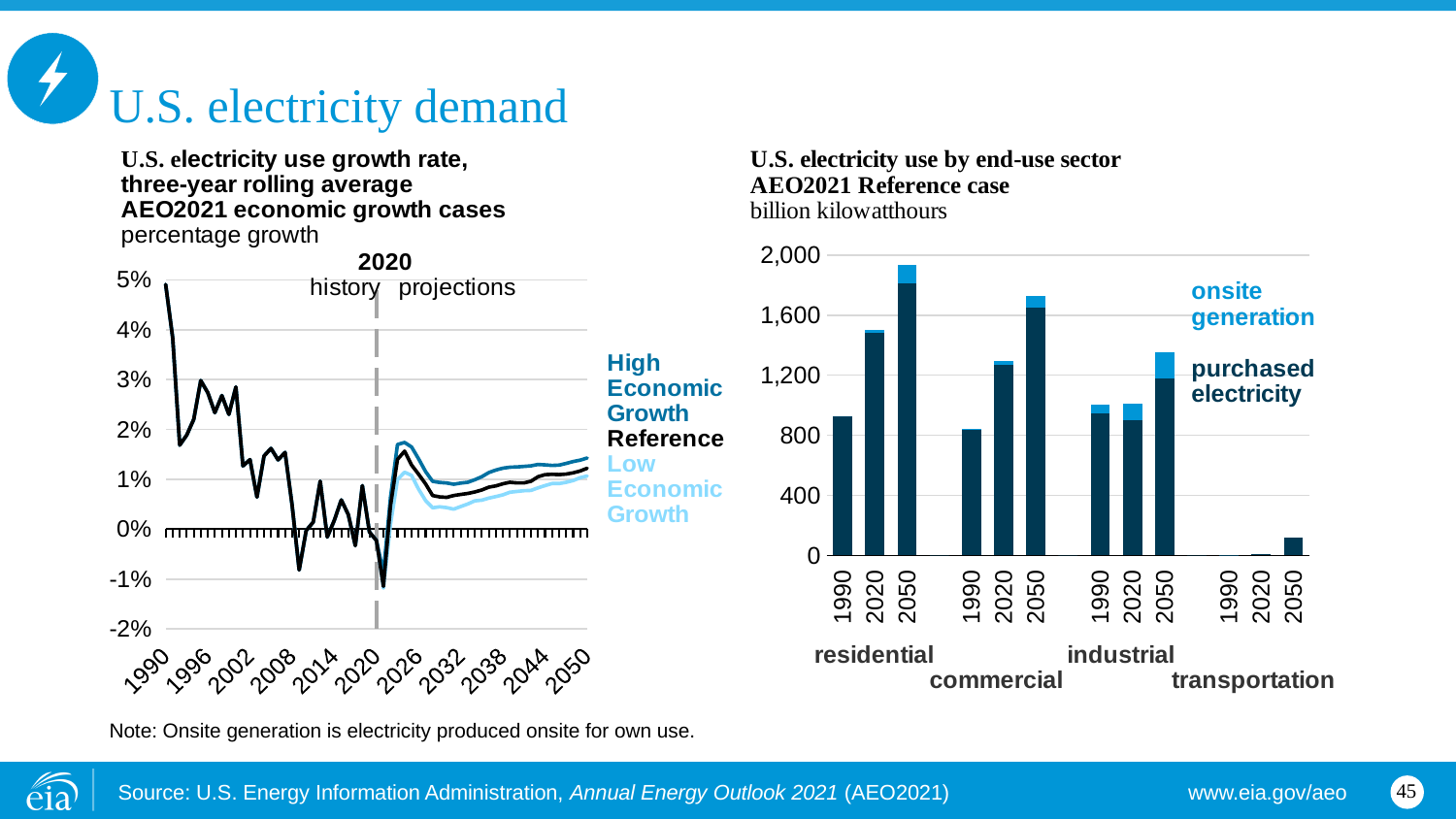
On the right chart, how many end-use sectors are shown? 4 On the right chart, is the total for transportation in 2050 greater or less than 400 billion kilowatthours? less How many economic growth cases are plotted on the left chart? 3 On the right chart, which sector and year has the tallest bar? residential, 2050 On the left chart, is the growth rate in 1990 greater or less than 4%? greater On the right chart, how many series does the legend list? 2 What kind of chart is the 'U.S. electricity use growth rate' chart on the left? line chart On the right chart, which is larger in 2020, residential or commercial electricity use? residential On the left chart, does the growth rate generally rise or fall over the history period from 1990 to 2020? fall On the right chart, is the total for residential in 2050 greater or less than 1,600 billion kilowatthours? greater What kind of chart is the 'U.S. electricity use by end-use sector' chart on the right? bar chart On the left chart, which case has the higher growth rate in 2050, High Economic Growth or Low Economic Growth? High Economic Growth